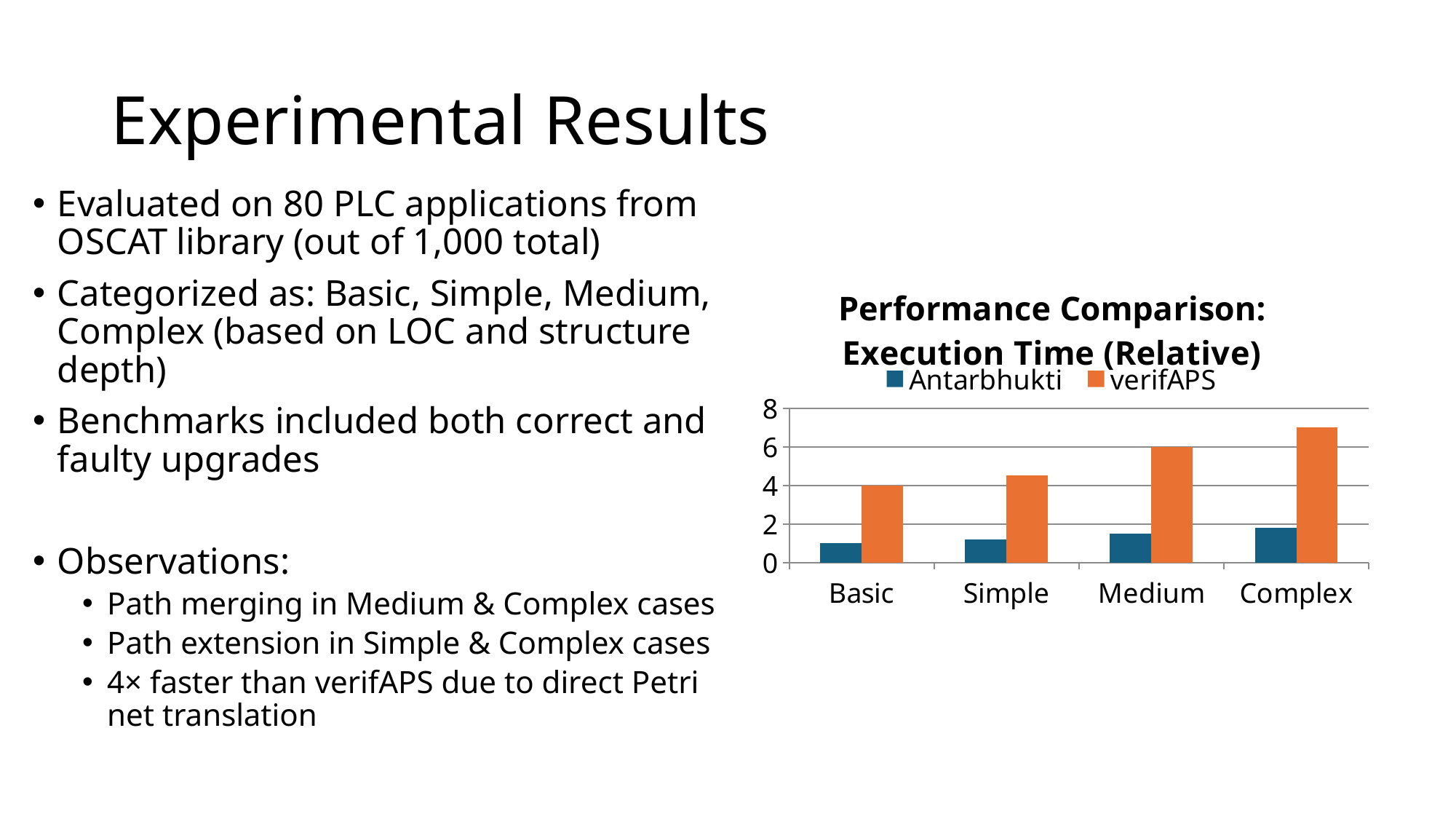
Is the value for Antarbhukti in the Complex category greater or less than 2? less What is the value for verifAPS in the Medium category? 6 Is the value for verifAPS in the Simple category greater or less than 4? greater Is the value for verifAPS in the Complex category greater or less than 6? greater In which category is the verifAPS value highest? Complex In the Medium category, which series has the larger value, Antarbhukti or verifAPS? verifAPS Do the verifAPS values rise or fall from Basic to Complex? rise How many series does the chart legend list? 2 What is the value for verifAPS in the Basic category? 4 What kind of chart is shown on the slide? bar chart How many categories are shown on the x axis of the chart? 4 In which category is the verifAPS value lowest? Basic